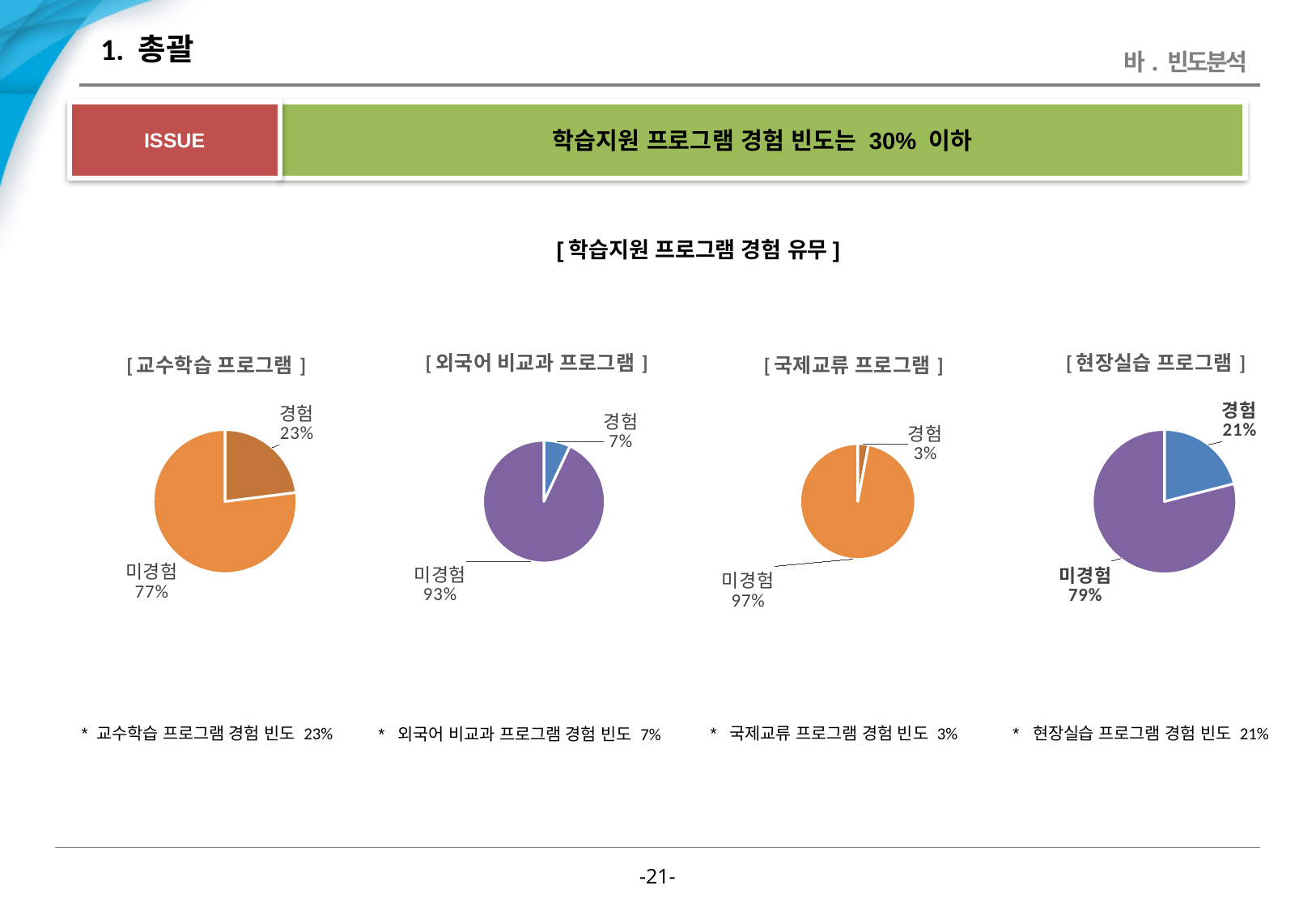
How many pie charts are shown on the slide? 4 In the [외국어 비교과 프로그램] pie chart, what is the difference between 미경험 and 경험? 86% How many slices does the [교수학습 프로그램] pie chart have? 2 What kind of chart is the [국제교류 프로그램] chart? Pie chart In the [국제교류 프로그램] pie chart, which slice is the smallest? 경험 In the [외국어 비교과 프로그램] pie chart, what is the value for 경험? 7% In the [교수학습 프로그램] pie chart, what is the value for 경험? 23% Which is larger: 경험 in the [교수학습 프로그램] chart or 경험 in the [현장실습 프로그램] chart? 경험 in the [교수학습 프로그램] chart In the [교수학습 프로그램] pie chart, what is the value for 미경험? 77% In the [현장실습 프로그램] pie chart, what is the value for 경험? 21% In the [국제교류 프로그램] pie chart, what is the value for 미경험? 97% In the [현장실습 프로그램] pie chart, which slice is the largest? 미경험